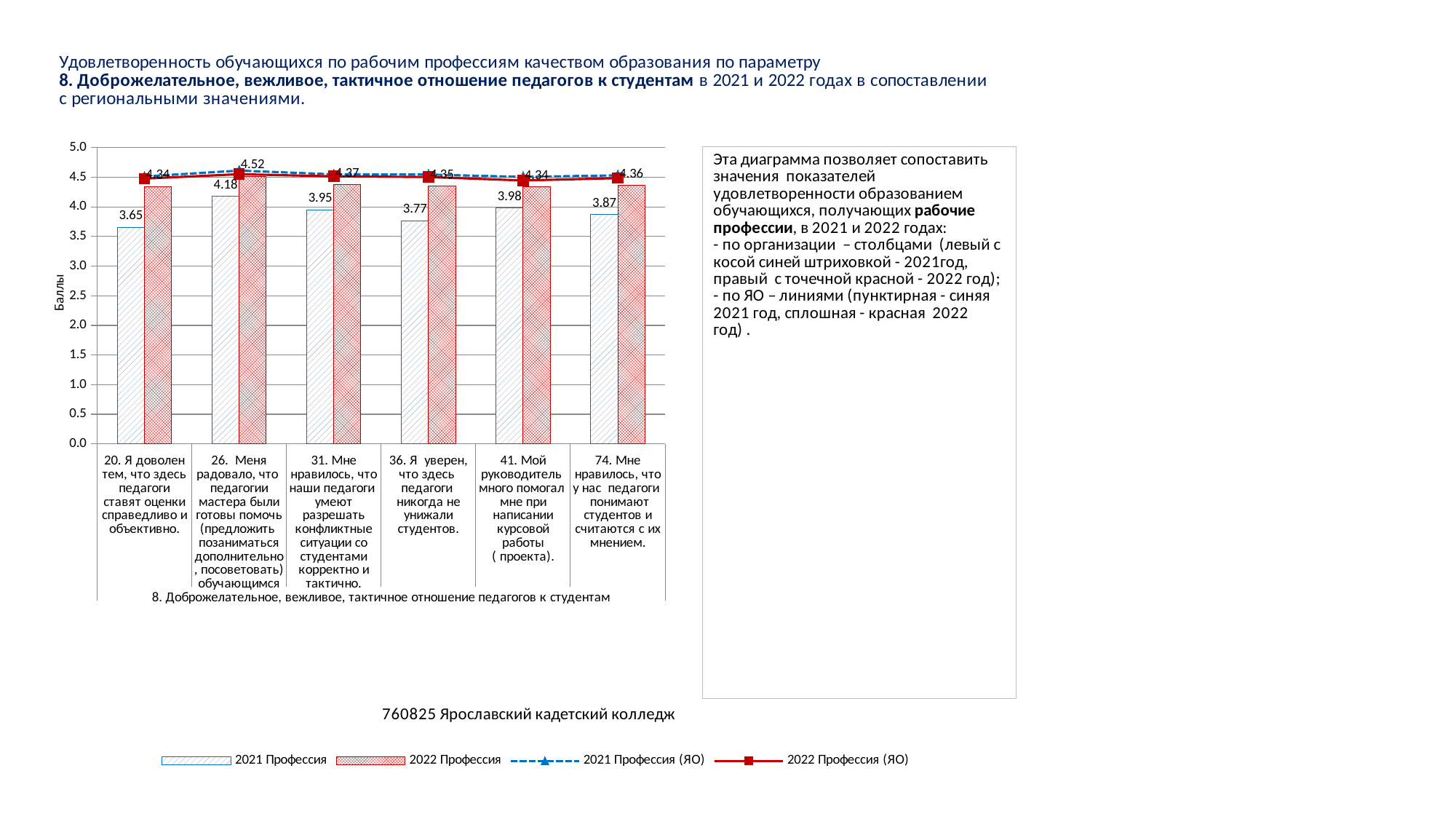
What is the 2021 Профессия value for category 74 (Мне нравилось, что у нас педагоги понимают студентов и считаются с их мнением)? 3.87 What is the 2021 Профессия value for category 41 (Мой руководитель много помогал мне при написании курсовой работы)? 3.98 How many series does the legend list? 4 What is the 2021 Профессия value for category 26 (Меня радовало, что педагогии мастера были готовы помочь)? 4.18 What is the difference between the highest and lowest 2021 Профессия values (4.18 and 3.65)? 0.53 How many categories (questions) are shown on the x axis? 6 Which category has the highest 2021 Профессия value? 26. Меня радовало, что педагогии мастера были готовы помочь For category 20, which is larger: the 2021 Профессия bar or the 2022 Профессия bar? 2022 Профессия Which category has the lowest 2021 Профессия value? 20. Я доволен тем, что здесь педагоги ставят оценки справедливо и объективно What is the 2021 Профессия value for category 20 (Я доволен тем, что здесь педагоги ставят оценки справедливо и объективно)? 3.65 Is the 2022 Профессия value for category 36 (Я уверен, что здесь педагоги никогда не унижали студентов) greater or less than 4.0? greater What is the label of the vertical axis? Баллы